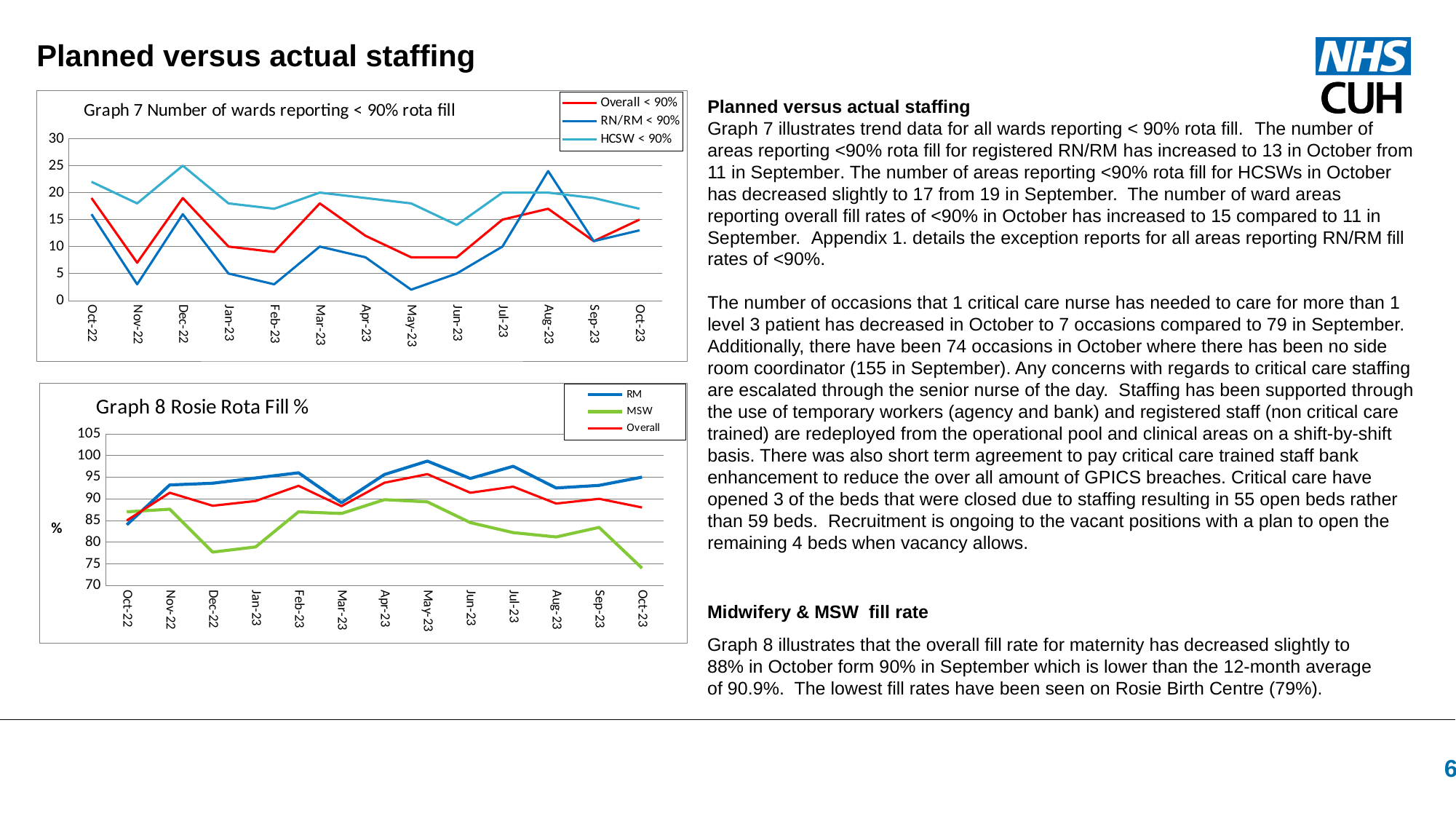
In Graph 7 Number of wards reporting < 90% rota fill, is the RN/RM < 90% value for Aug-23 greater or less than 20? greater In Graph 8 Rosie Rota Fill %, does the MSW series rise or fall from Sep-23 to Oct-23? fall In Graph 7 Number of wards reporting < 90% rota fill, what is the HCSW < 90% value for Dec-22? 25 In Graph 7 Number of wards reporting < 90% rota fill, what is the Overall < 90% value for Oct-23? 15 In Graph 7 Number of wards reporting < 90% rota fill, which series is higher in Aug-23: RN/RM < 90% or HCSW < 90%? RN/RM < 90% How many months are plotted along the x axis of Graph 8 Rosie Rota Fill %? 13 In Graph 8 Rosie Rota Fill %, is the MSW value for Dec-22 greater or less than 80? less What kind of chart is Graph 7 Number of wards reporting < 90% rota fill? Line chart How many series does the legend of Graph 7 Number of wards reporting < 90% rota fill list? 3 In Graph 7 Number of wards reporting < 90% rota fill, in which month is the HCSW < 90% series highest? Dec-22 What is the label on the vertical axis of Graph 8 Rosie Rota Fill %? % In Graph 8 Rosie Rota Fill %, in which month is the MSW series lowest? Oct-23